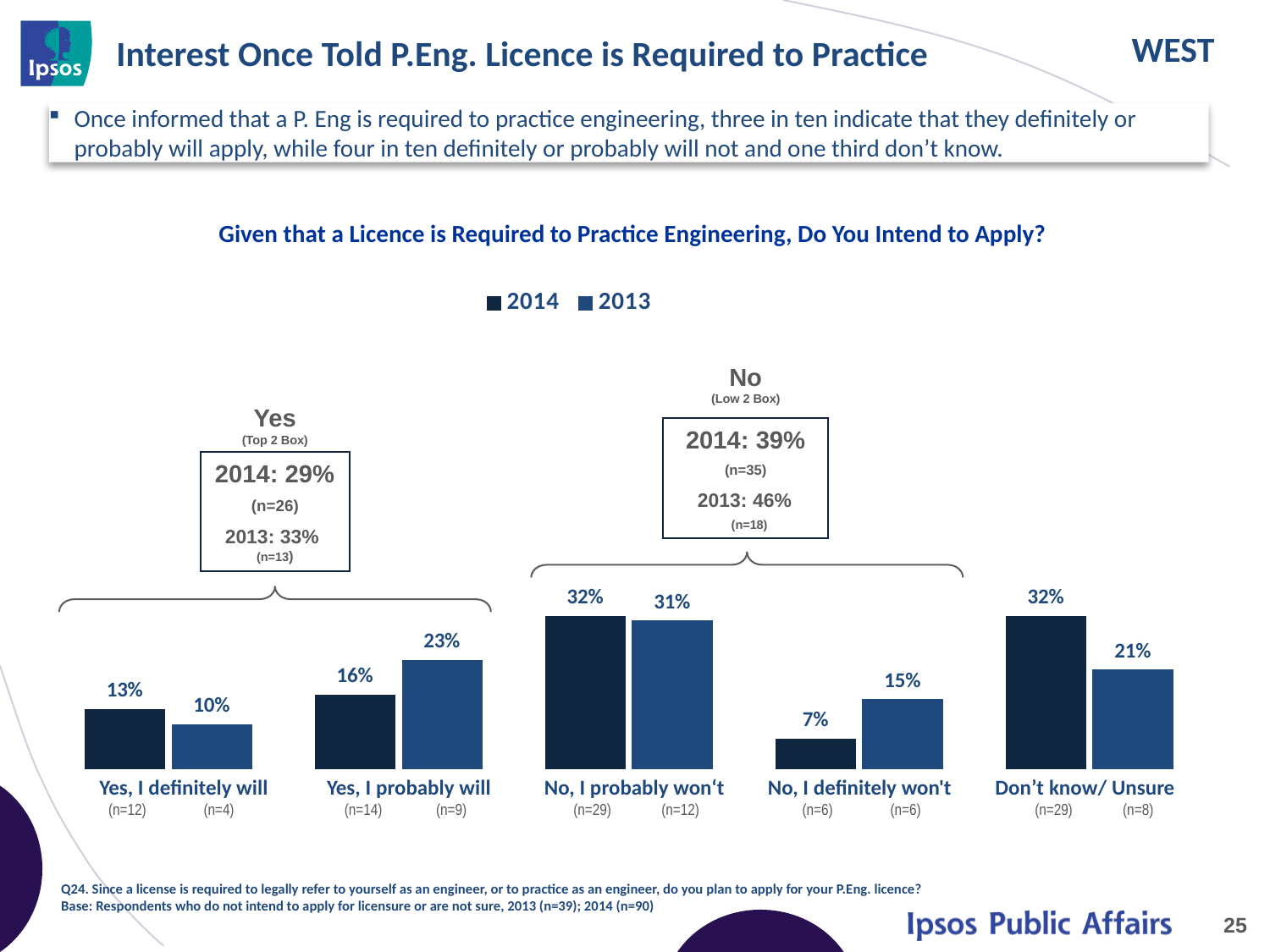
What is the 2013 value for "Don't know/ Unsure"? 21% How many series does the legend list? 2 How many response categories are shown on the x axis? 5 What is the difference between the 2014 and 2013 values for "Don't know/ Unsure"? 11% What kind of chart is shown on the slide? Bar chart What is the 2014 value for "Yes, I definitely will"? 13% Which category has the highest 2013 value? No, I probably won't What is the 2014 value for "No, I probably won't"? 32% What is the 2014 "No (Low 2 Box)" total shown in the callout box? 39% What is the 2013 value for "Yes, I probably will"? 23% Which category has the lowest 2014 value? No, I definitely won't Which is larger for "No, I definitely won't": the 2014 value or the 2013 value? 2013